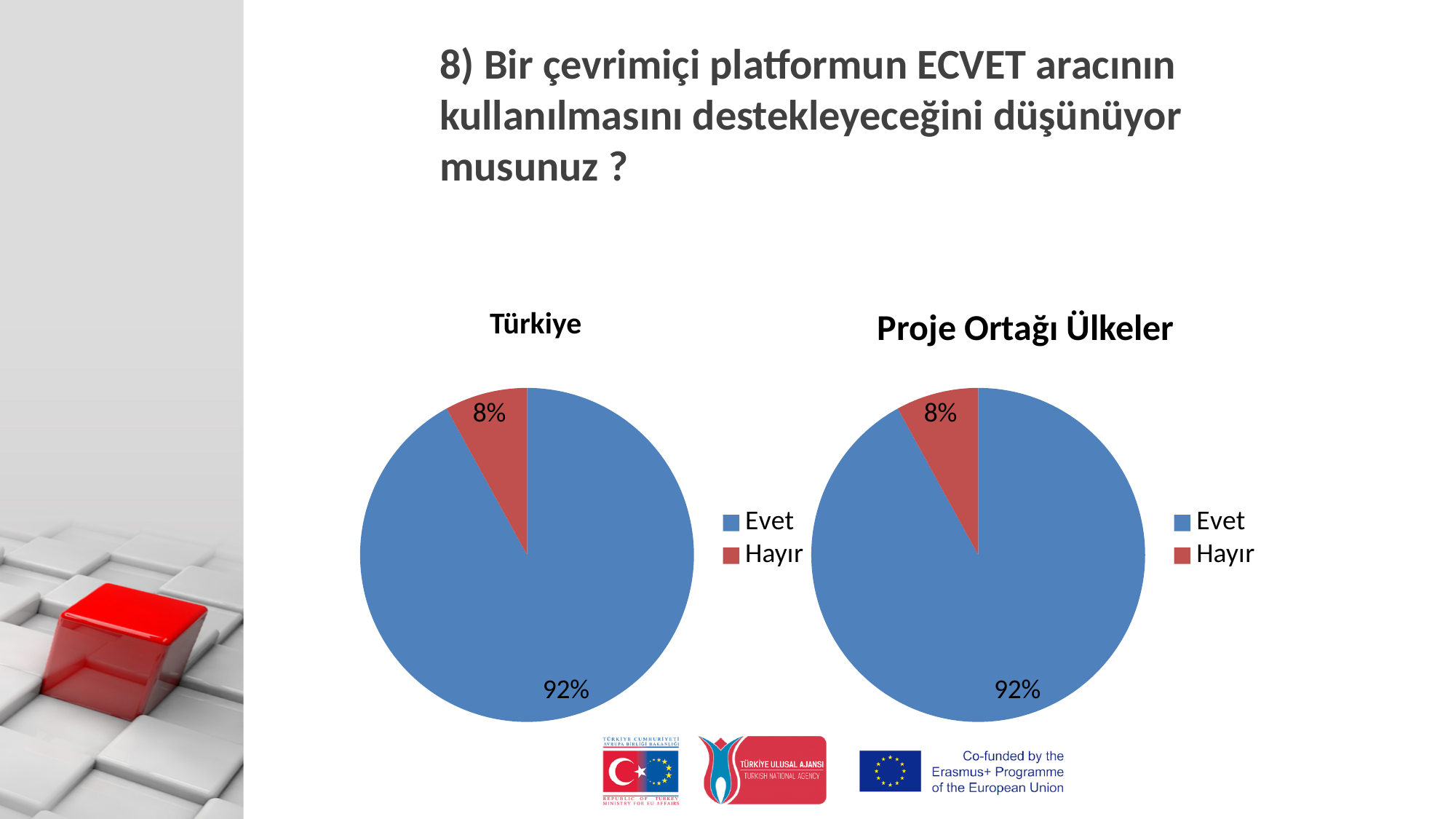
In the Proje Ortağı Ülkeler chart, what share of the pie is Evet? 92% In the Türkiye chart, which slice is the largest? Evet In the Türkiye chart, what share of the pie is Evet? 92% In the Proje Ortağı Ülkeler chart, which slice is the smallest? Hayır In the Proje Ortağı Ülkeler chart, which is larger, Evet or Hayır? Evet How many slices does the Proje Ortağı Ülkeler pie chart have? 2 In the Türkiye chart, what is the difference between the Evet and Hayır shares? 84% How many entries does the legend of the Türkiye chart list? 2 In the Türkiye chart, what share of the pie is Hayır? 8% What kind of chart is the Türkiye chart? Pie chart In the Proje Ortağı Ülkeler chart, what colour is the Hayır slice? Red